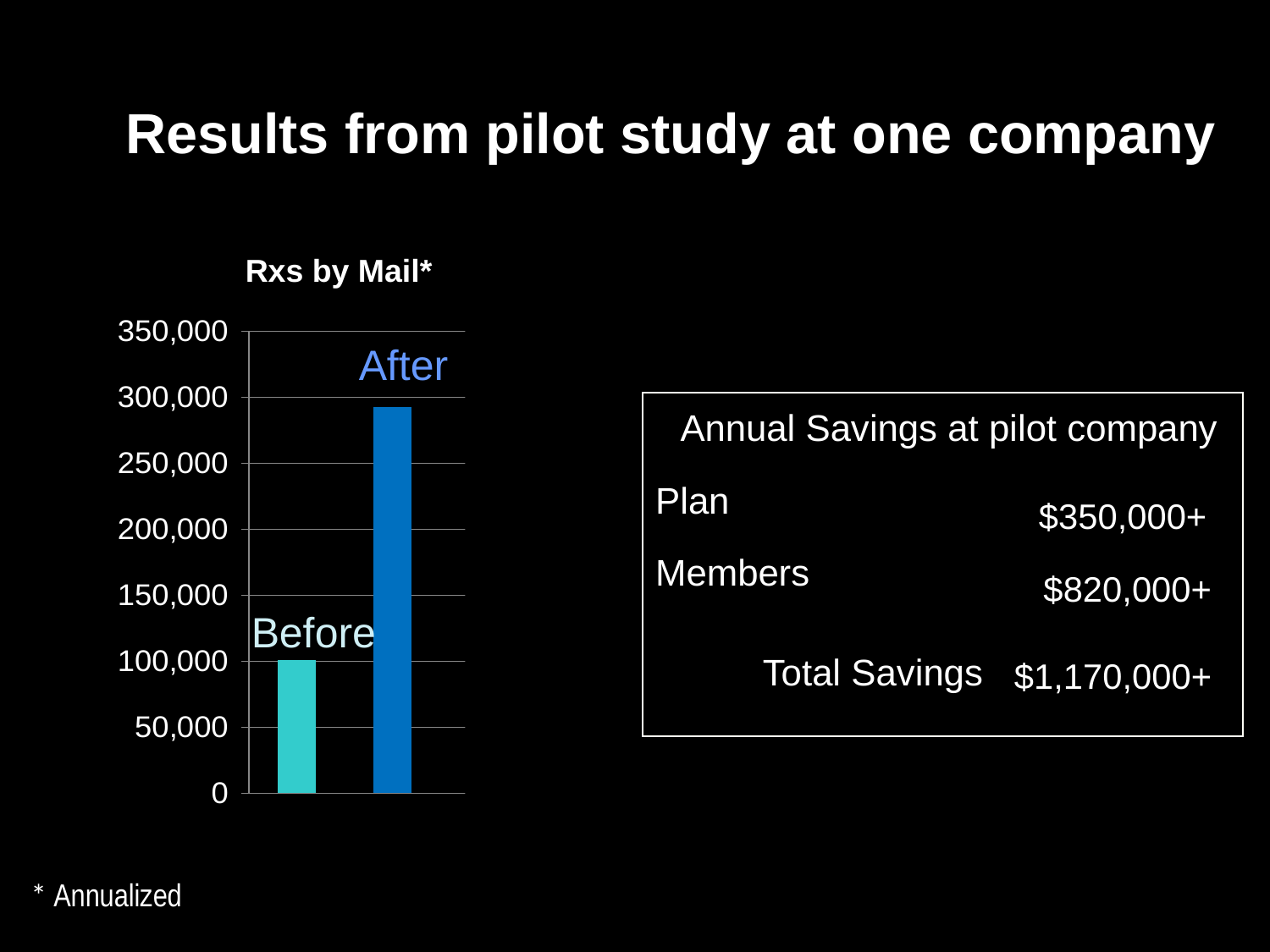
How many bars are plotted in the chart? 2 Which category has the highest value in the chart? After What is the maximum value shown on the vertical axis of the chart? 350,000 Is the value for Before greater or less than 50,000? greater What is the title of the chart? Rxs by Mail* Do the values rise or fall from Before to After? rise What kind of chart is shown on the slide? bar chart Which is larger, the value for Before or the value for After? After Is the value for After greater or less than 250,000? greater Is the value for Before greater or less than 150,000? less Which category has the lowest value in the chart? Before